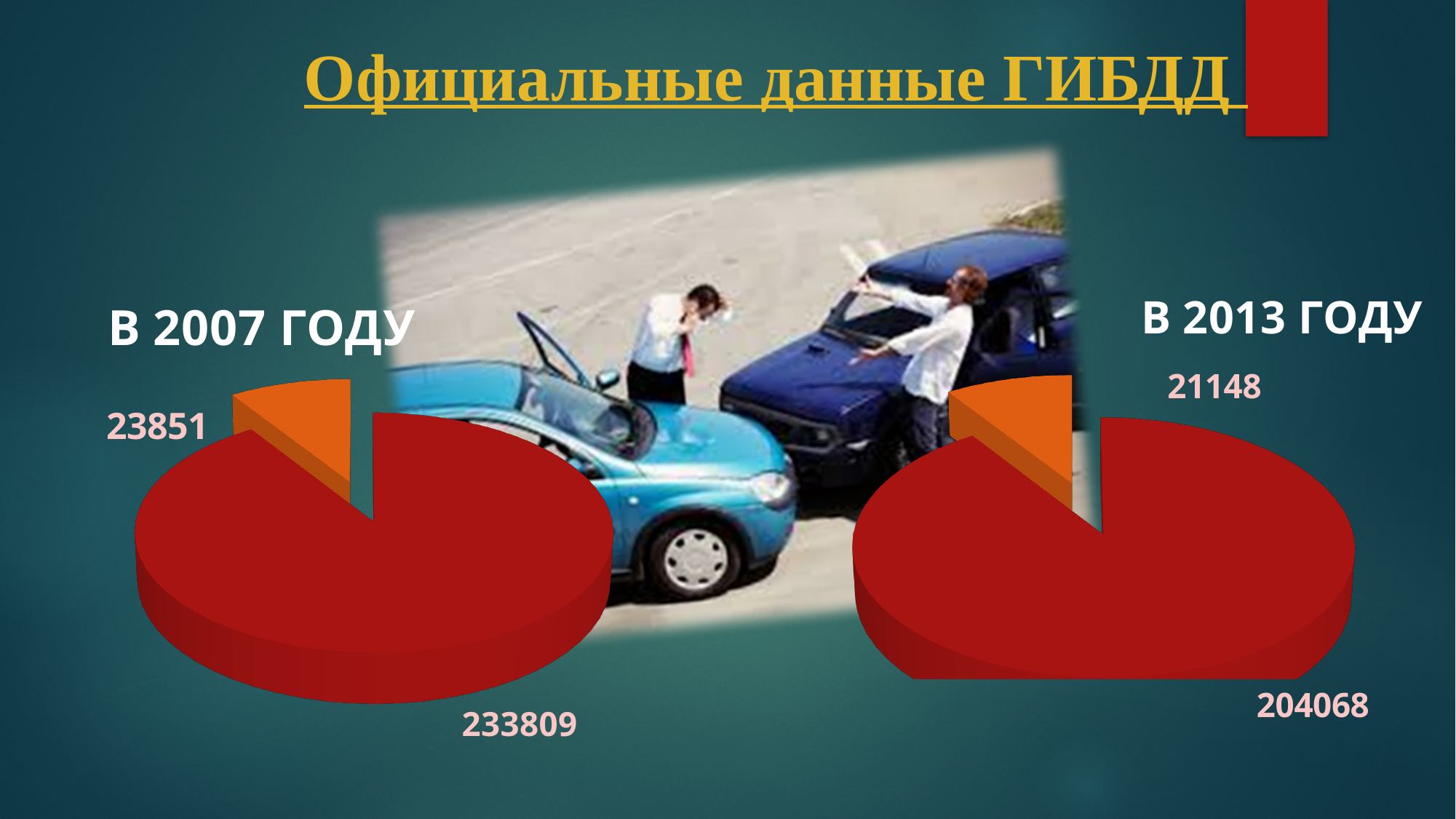
In the "В 2013 ГОДУ" chart, what is the value of the orange slice? 21148 What is the total of the two slices in the "В 2013 ГОДУ" chart? 225216 In the "В 2007 ГОДУ" chart, what is the difference between the red slice and the orange slice? 209958 In the "В 2007 ГОДУ" chart, which slice has the largest value? the red slice (233809) In the "В 2007 ГОДУ" chart, what is the value of the red slice? 233809 What type of chart is used for "В 2007 ГОДУ"? pie chart In the "В 2013 ГОДУ" chart, which slice has the smallest value? the orange slice (21148) In the "В 2007 ГОДУ" chart, what is the value of the orange slice? 23851 Which is larger: the red slice in the "В 2007 ГОДУ" chart or the red slice in the "В 2013 ГОДУ" chart? the red slice in the "В 2007 ГОДУ" chart (233809) How many slices does the "В 2013 ГОДУ" pie chart have? 2 What is the title of the slide containing the two pie charts? Официальные данные ГИБДД In the "В 2013 ГОДУ" chart, what is the value of the red slice? 204068